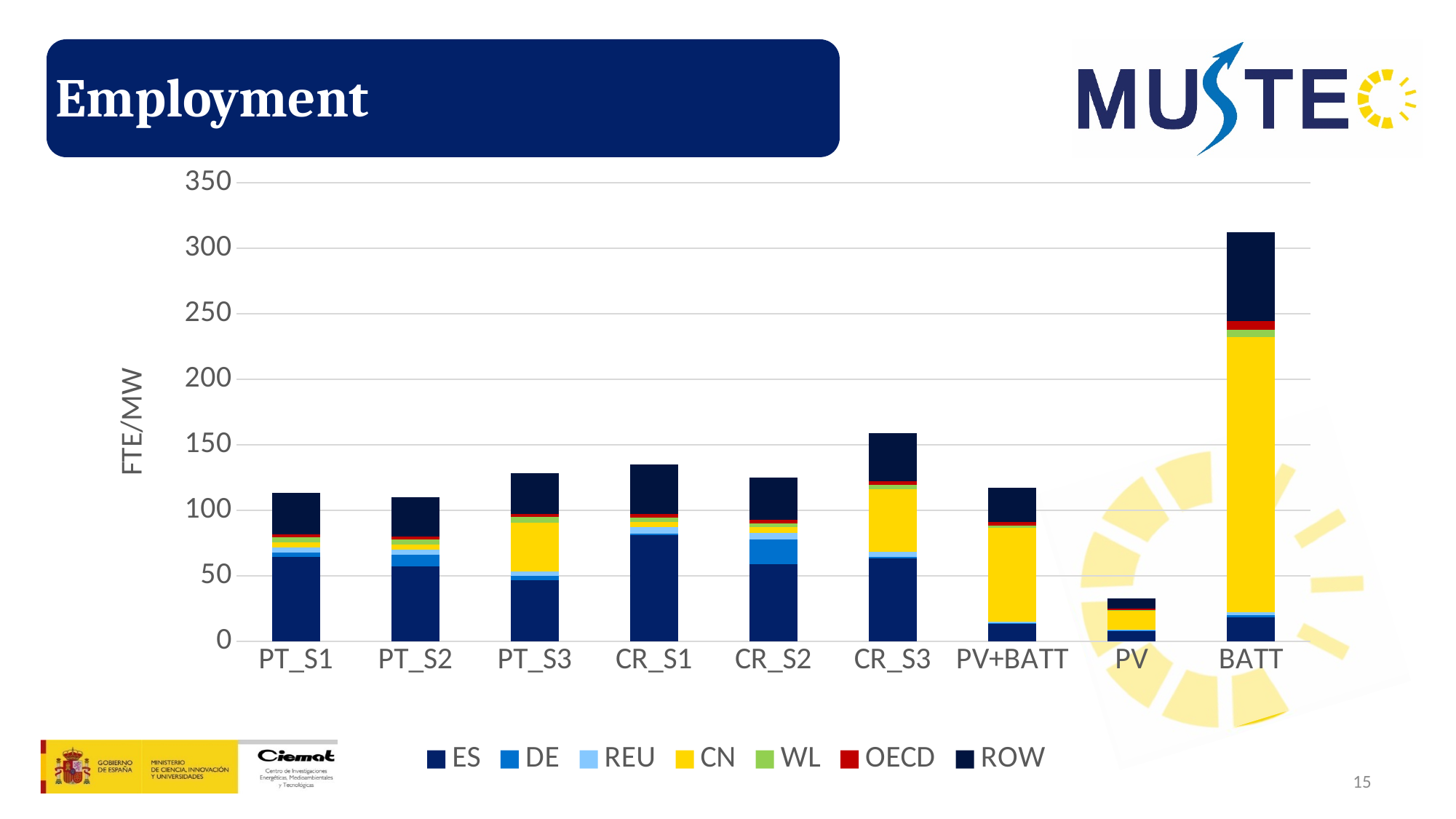
Is the total value for PV greater or less than 50? less How many categories are shown on the x axis of the chart? 9 Is the total value for CR_S1 greater or less than 150? less Is the total value for CR_S3 greater or less than 150? greater What is the label of the y axis? FTE/MW Which category has the lowest total employment (FTE/MW)? PV Which has a larger total, CR_S3 or PT_S1? CR_S3 Which category has the highest total employment (FTE/MW)? BATT How many series does the legend list? 7 What kind of chart is shown on the slide? Stacked bar chart Which series is shown in yellow in the legend? CN